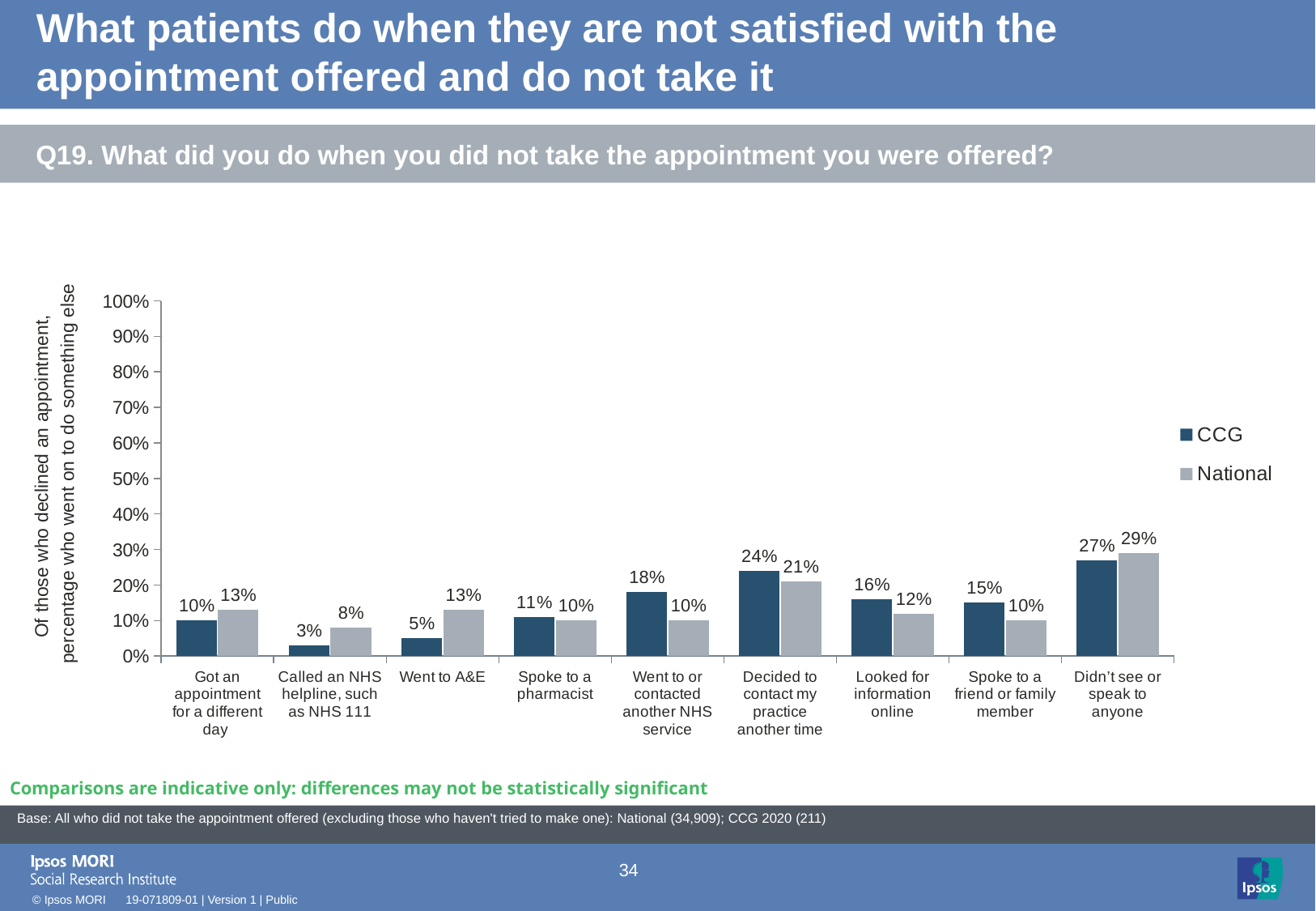
What is the difference between the CCG and National values for 'Went to or contacted another NHS service'? 8 percentage points What is the CCG value for 'Decided to contact my practice another time'? 24% What is the National value for 'Went to A&E'? 13% What kind of chart is shown on the slide? Bar chart For 'Spoke to a friend or family member', which is larger, the CCG value or the National value? CCG Is the National value for 'Didn't see or speak to anyone' greater or less than 20%? greater How many series does the legend list? 2 What is the CCG value for 'Called an NHS helpline, such as NHS 111'? 3% What are the two series named in the legend? CCG and National Which category has the highest CCG value? Didn't see or speak to anyone Which category has the lowest National value? Called an NHS helpline, such as NHS 111 How many categories are shown on the x axis? 9